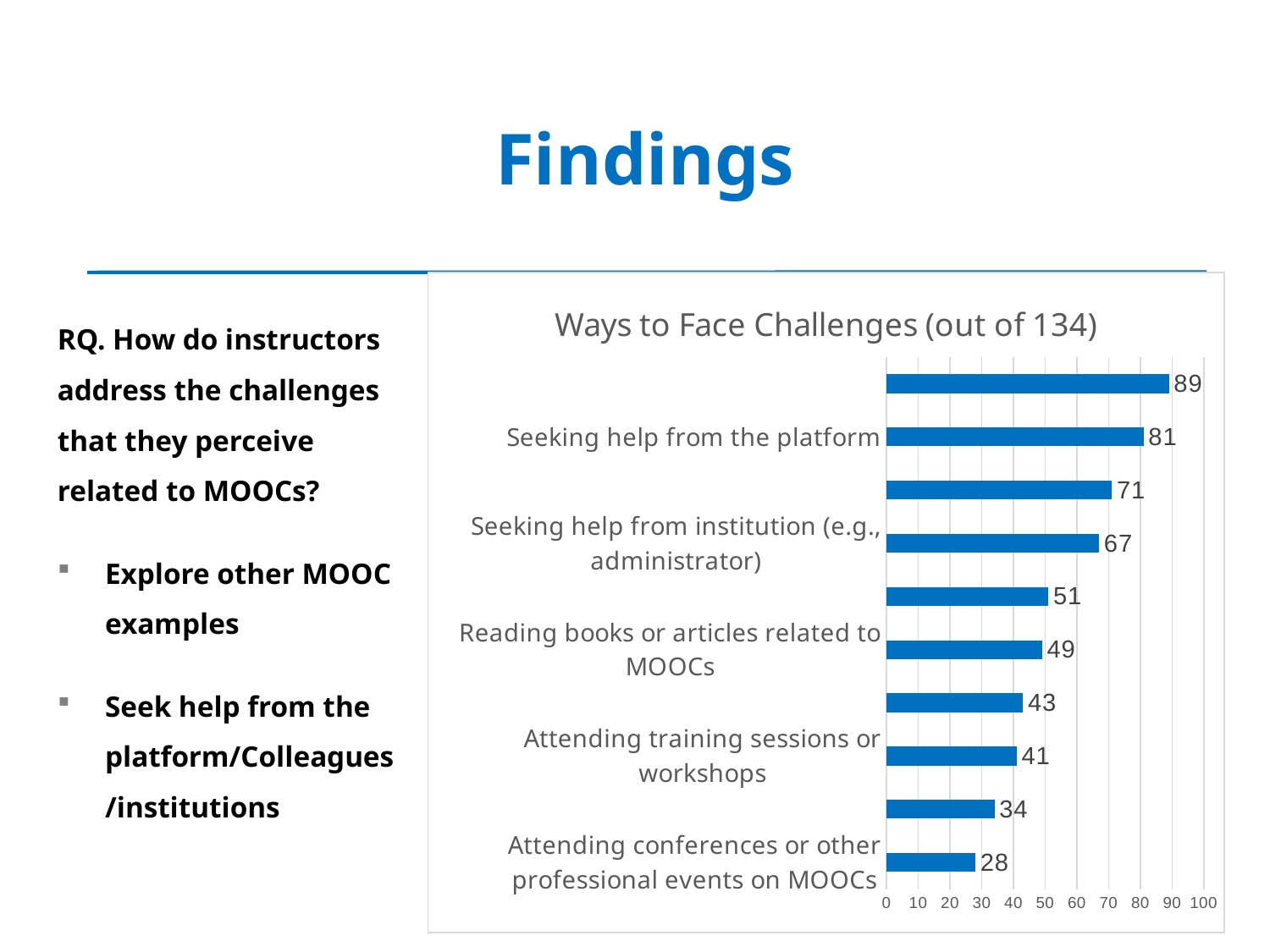
What is the title of the chart? Ways to Face Challenges (out of 134) What is the value for "Attending training sessions or workshops"? 41 Which category has the lowest value in the chart? Attending conferences or other professional events on MOOCs How many bars are plotted in the chart? 10 What is the value for "Seeking help from institution (e.g., administrator)"? 67 Is the value for "Attending training sessions or workshops" greater or less than 50? less What is the value for "Seeking help from the platform"? 81 Which is larger: the value for "Reading books or articles related to MOOCs" or for "Attending training sessions or workshops"? Reading books or articles related to MOOCs What is the value for "Reading books or articles related to MOOCs"? 49 What is the highest value shown on any bar in the chart? 89 What is the difference between the values for "Seeking help from the platform" and "Seeking help from institution (e.g., administrator)"? 14 What is the value for "Attending conferences or other professional events on MOOCs"? 28